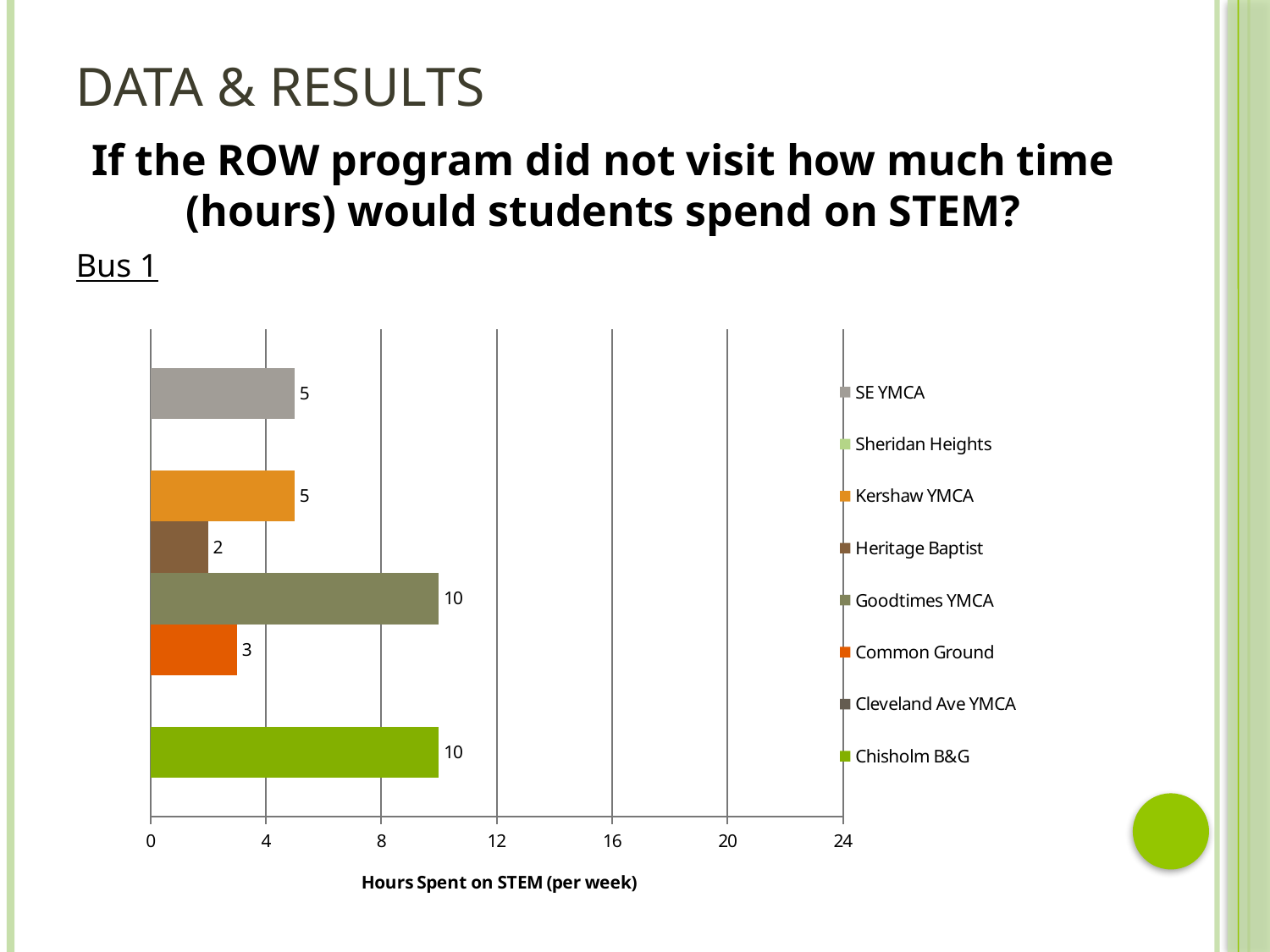
What value is shown for Common Ground? 3 What kind of chart is shown on the slide? bar chart What value is shown for Kershaw YMCA? 5 How many entries does the legend list? 8 What is the difference between the values for Goodtimes YMCA and Common Ground? 7 Is the value for Chisholm B&G greater or less than 8? greater What is the title of the horizontal axis? Hours Spent on STEM (per week) Which site has the lowest value among the bars shown? Heritage Baptist What value is shown for Goodtimes YMCA? 10 What value is shown for Chisholm B&G? 10 What value is shown for Heritage Baptist? 2 Which is larger, the value for Common Ground or the value for Heritage Baptist? Common Ground